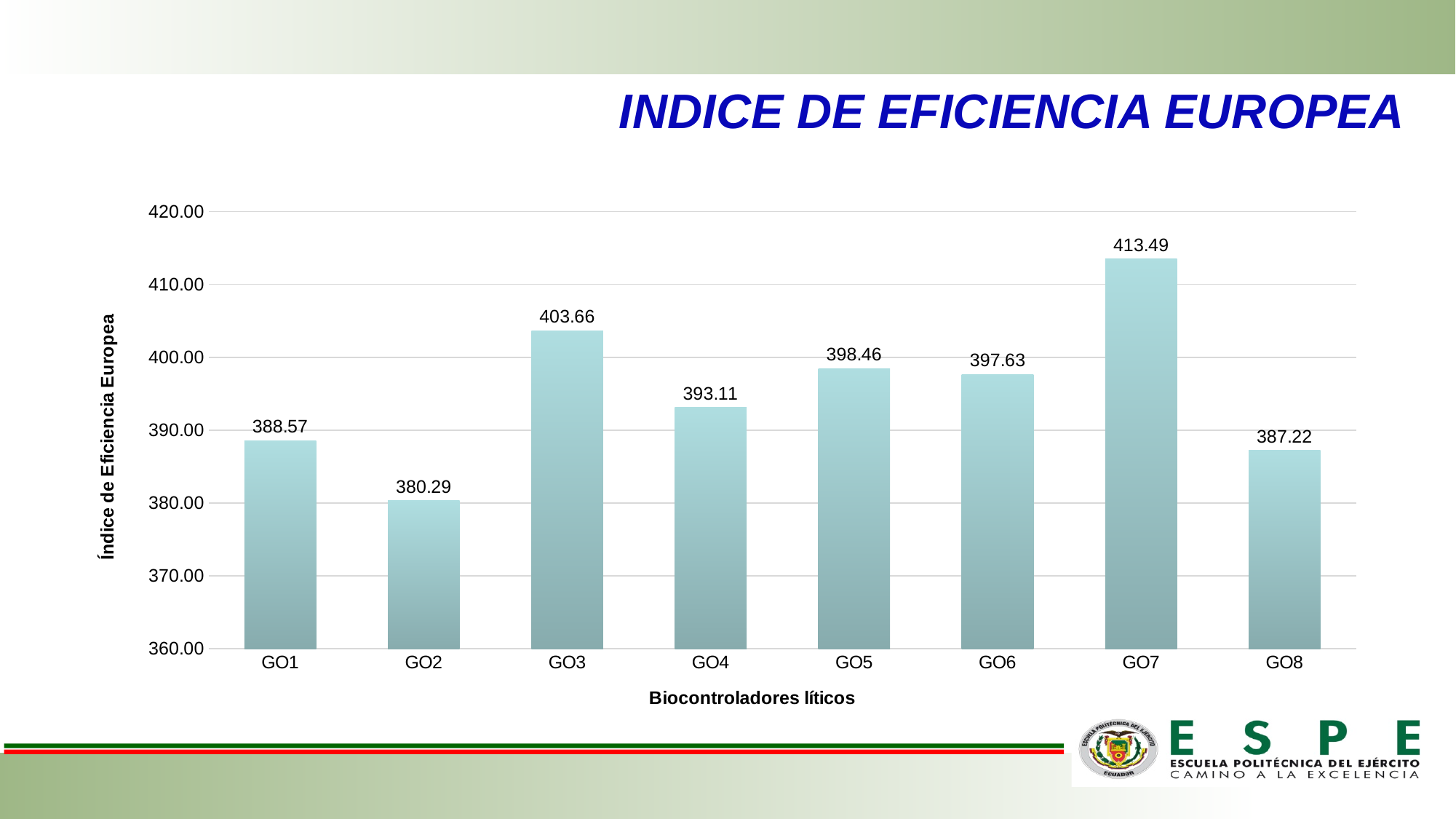
What is the difference between the values for GO3 and GO1? 15.09 What is the difference between the values for GO7 and GO2? 33.20 Is the value for GO4 greater or less than 390.00? greater What is the value for GO2? 380.29 How many categories are shown on the x axis? 8 What is the value for GO5? 398.46 What is the x-axis title of the chart? Biocontroladores líticos Which is larger, the value for GO3 or the value for GO4? GO3 Which category has the highest value? GO7 What is the value for GO7? 413.49 What kind of chart is shown on the slide? Bar chart Which category has the lowest value? GO2